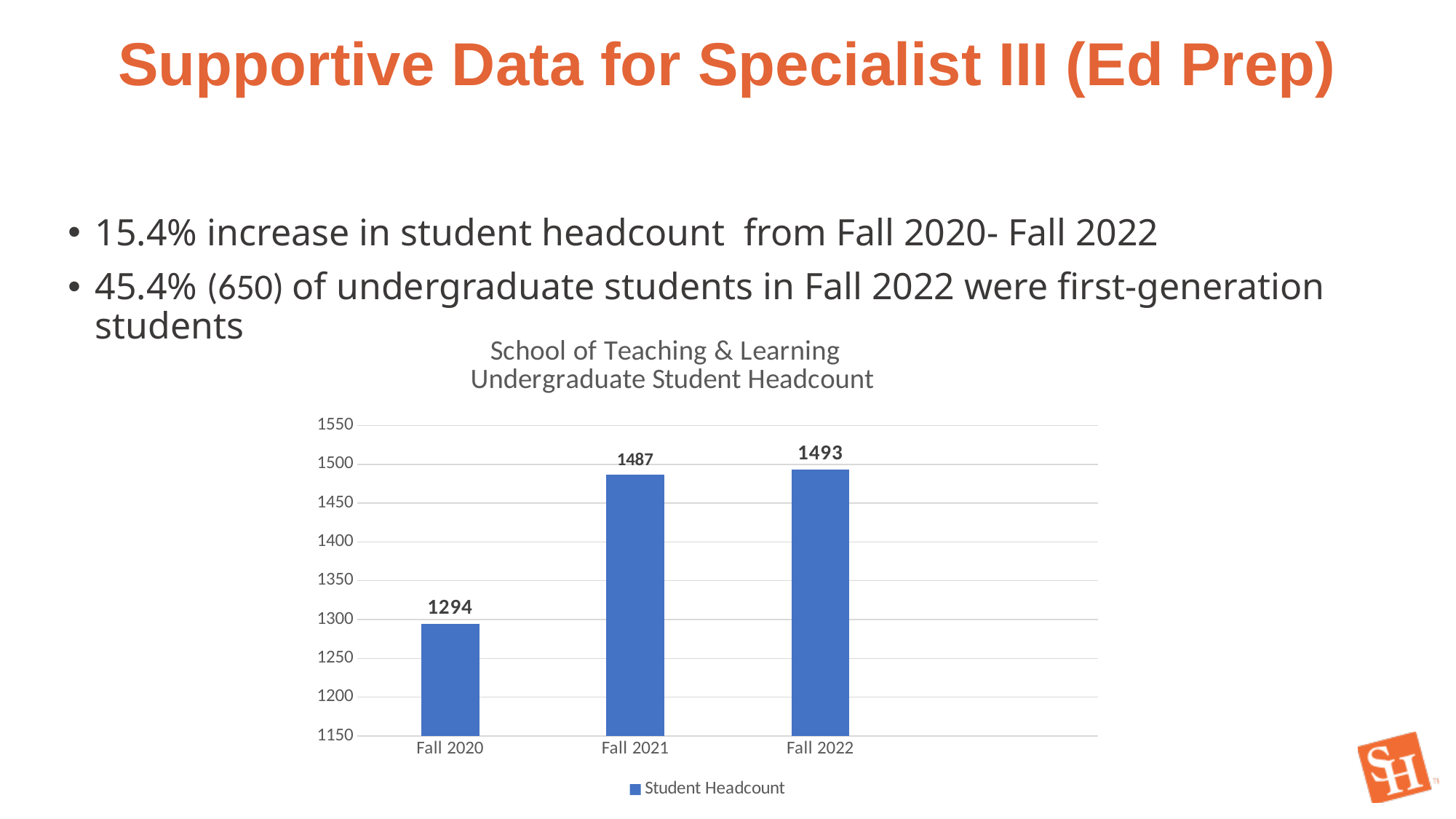
Is the student headcount for Fall 2020 greater or less than 1300? less What is the student headcount for Fall 2021? 1487 What is the difference in student headcount between Fall 2021 and Fall 2020? 193 What is the student headcount for Fall 2020? 1294 What is the difference in student headcount between Fall 2022 and Fall 2020? 199 Which term has the highest student headcount? Fall 2022 How many terms are shown on the chart? 3 What kind of chart is shown on the slide? bar chart Which is larger, the student headcount for Fall 2020 or for Fall 2021? Fall 2021 What is the student headcount for Fall 2022? 1493 Which term has the lowest student headcount? Fall 2020 What is the title of the chart? School of Teaching & Learning Undergraduate Student Headcount